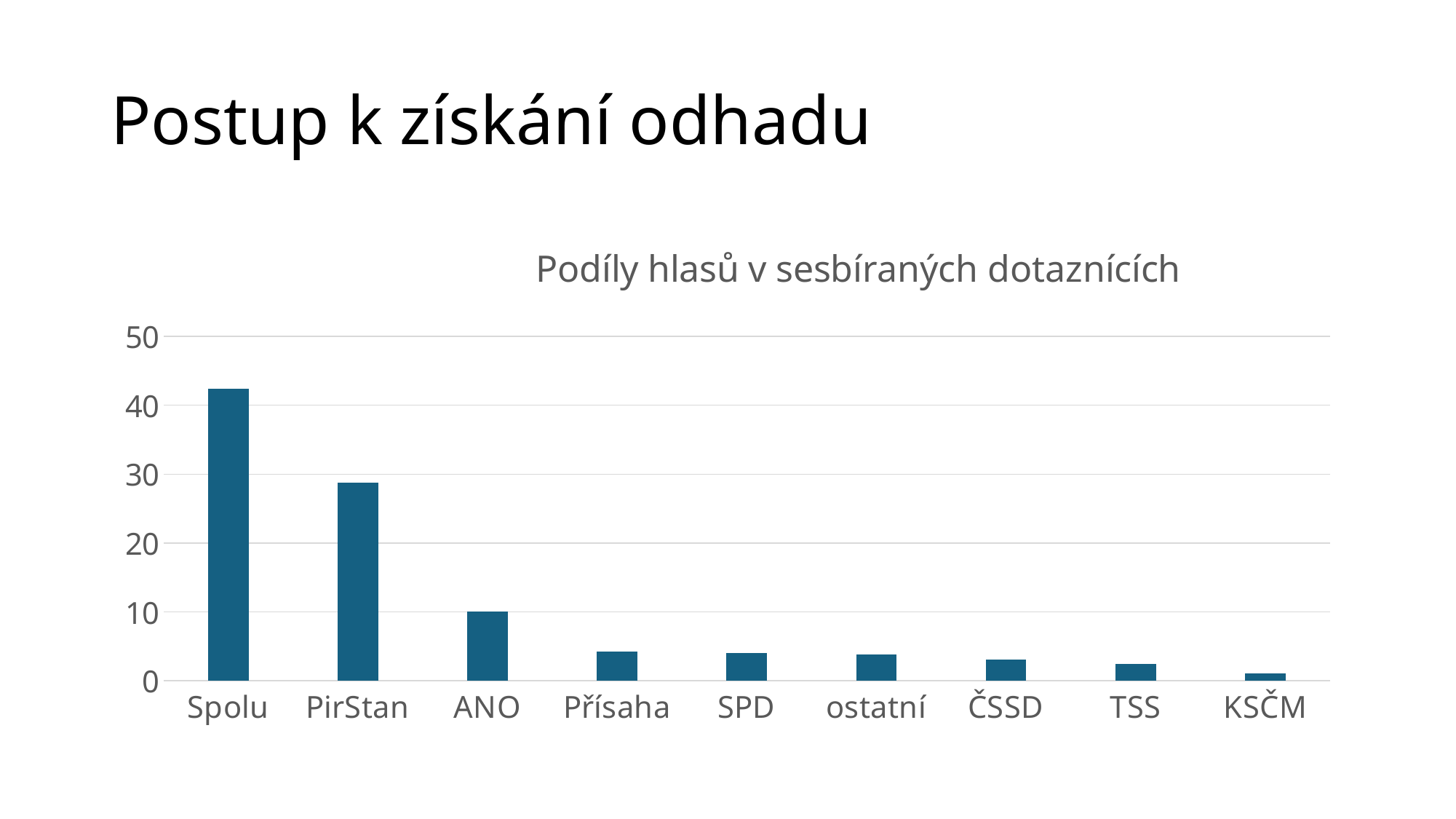
How many categories are shown on the x axis of the chart? 9 What kind of chart is shown on the slide? bar chart Is the value for PirStan greater or less than 20? greater Which has a larger value, PirStan or ANO? PirStan Is the value for Spolu greater or less than 40? greater Which has a larger value, ANO or Přísaha? ANO Do the values rise or fall from left to right along the x axis? fall What is the title of the chart? Podíly hlasů v sesbíraných dotaznících Which has a larger value, Spolu or PirStan? Spolu Which category has the lowest value in the chart? KSČM Is the value for ANO greater or less than 20? less Which category has the highest value in the chart? Spolu